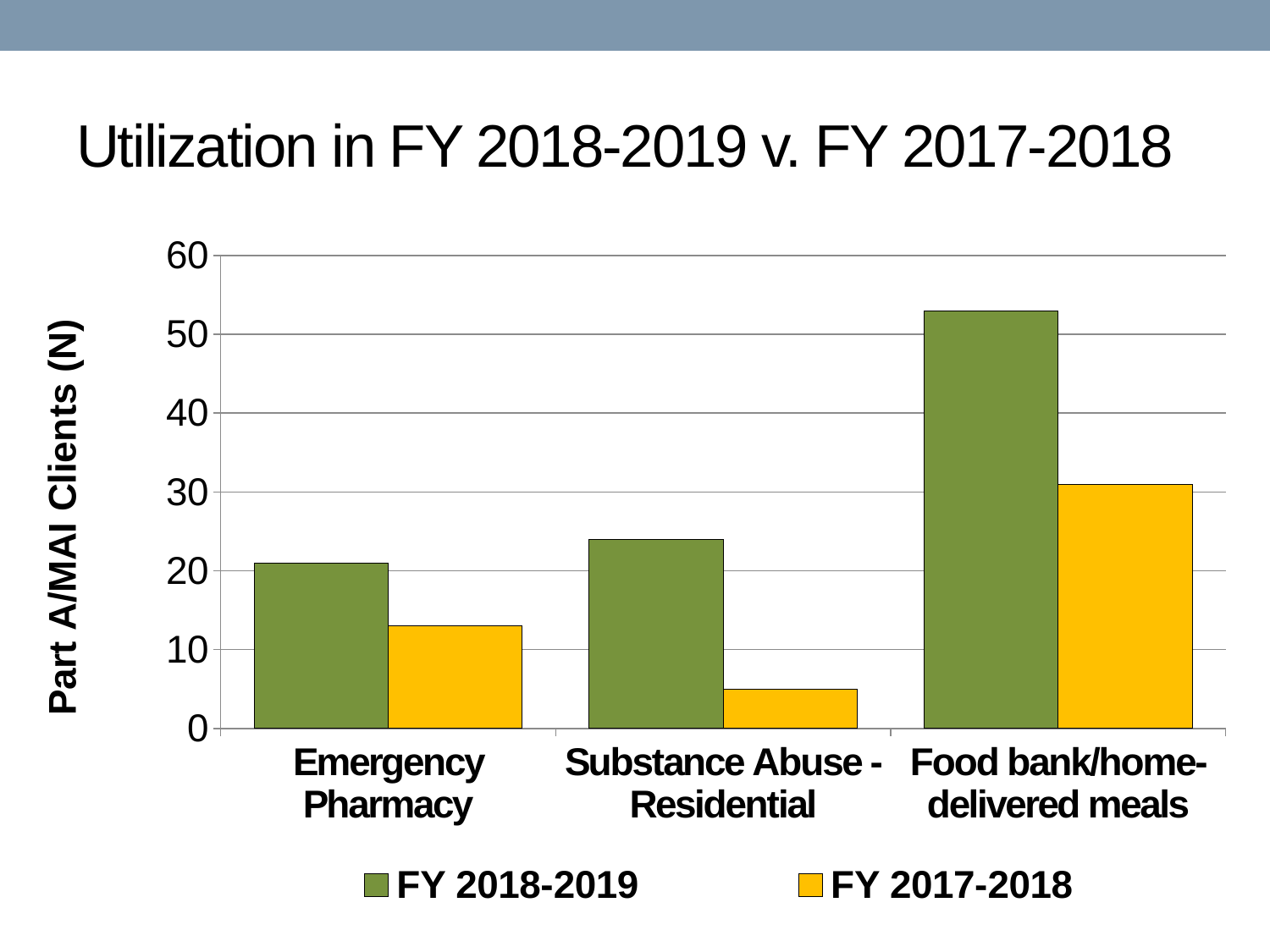
Is the FY 2018-2019 value for Substance Abuse - Residential greater or less than 20? greater For Emergency Pharmacy, which series has the larger value, FY 2018-2019 or FY 2017-2018? FY 2018-2019 What is the label of the y axis? Part A/MAI Clients (N) How many series does the legend list? 2 Is the FY 2017-2018 value for Substance Abuse - Residential greater or less than 10? less Which category has the lowest FY 2017-2018 value? Substance Abuse - Residential Is the FY 2017-2018 value for Food bank/home-delivered meals greater or less than 20? greater How many categories are shown on the x axis? 3 Which category has the highest FY 2018-2019 value? Food bank/home-delivered meals What kind of chart is shown on the slide? bar chart Which is larger: the FY 2017-2018 value for Emergency Pharmacy or the FY 2017-2018 value for Substance Abuse - Residential? Emergency Pharmacy